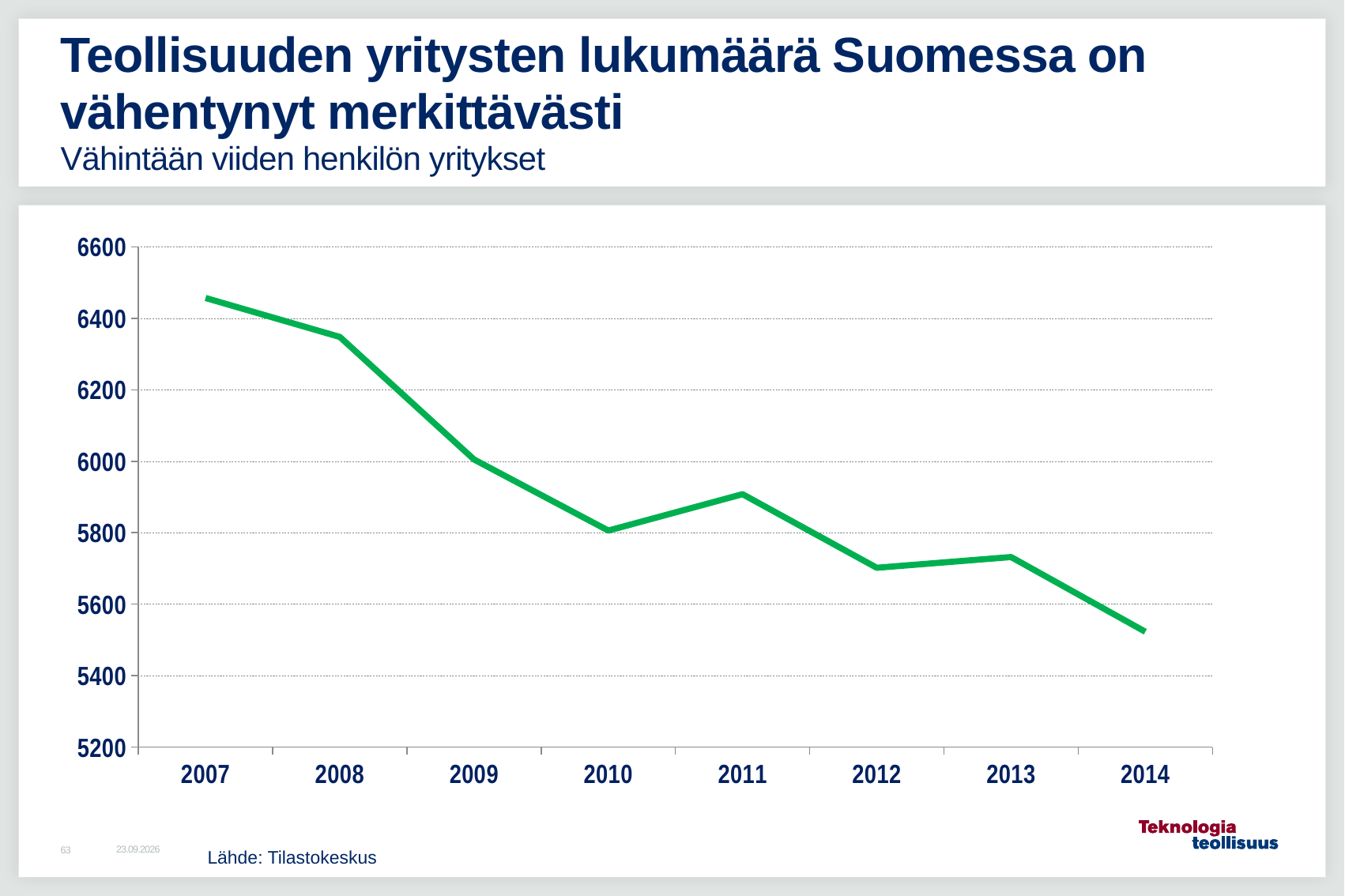
Do the values generally rise or fall from 2007 to 2014? fall Which year has the highest value? 2007 Is the value for 2007 greater or less than 6400? greater How many years are plotted on the x axis? 8 Which year has the lowest value? 2014 Is the value for 2012 greater or less than 5800? less Is the value for 2014 greater or less than 5600? less What source is cited below the chart? Tilastokeskus What kind of chart is shown on the slide? line chart Which year has the larger value, 2010 or 2011? 2011